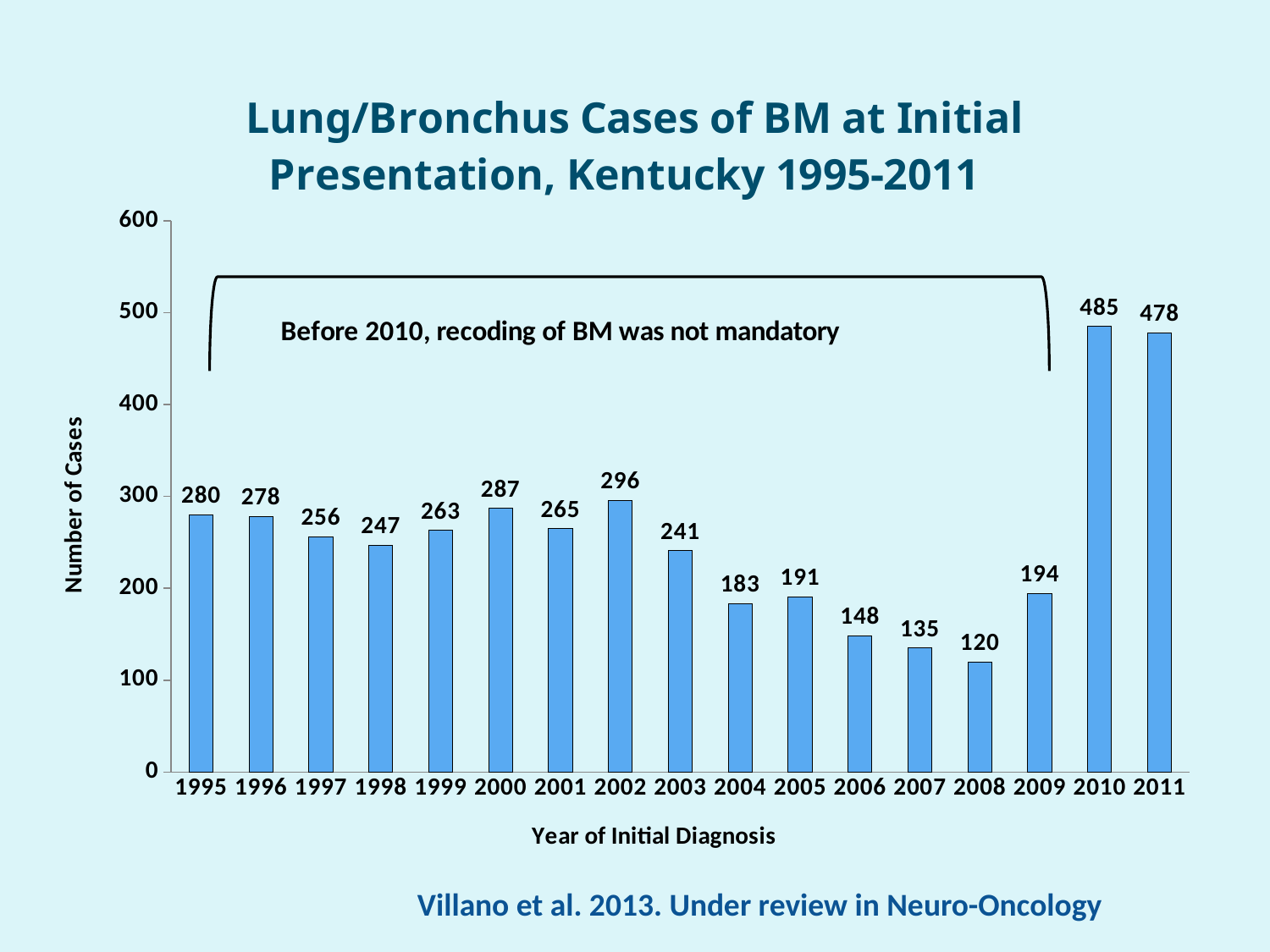
What does the annotation above the bars say about the years before 2010? Before 2010, recoding of BM was not mandatory What is the label of the y axis? Number of Cases How many years are shown on the x axis? 17 Which year has the lowest number of cases? 2008 Which year has the highest number of cases? 2010 Do the values rise or fall from 2002 to 2008? Fall Which year had more cases, 1995 or 2003? 1995 What is the number of cases for 2008? 120 How many cases were recorded in 2002? 296 What kind of chart is shown on the slide? Bar chart Is the value for 2006 greater or less than 200? less What is the difference in cases between 2010 and 2009? 291